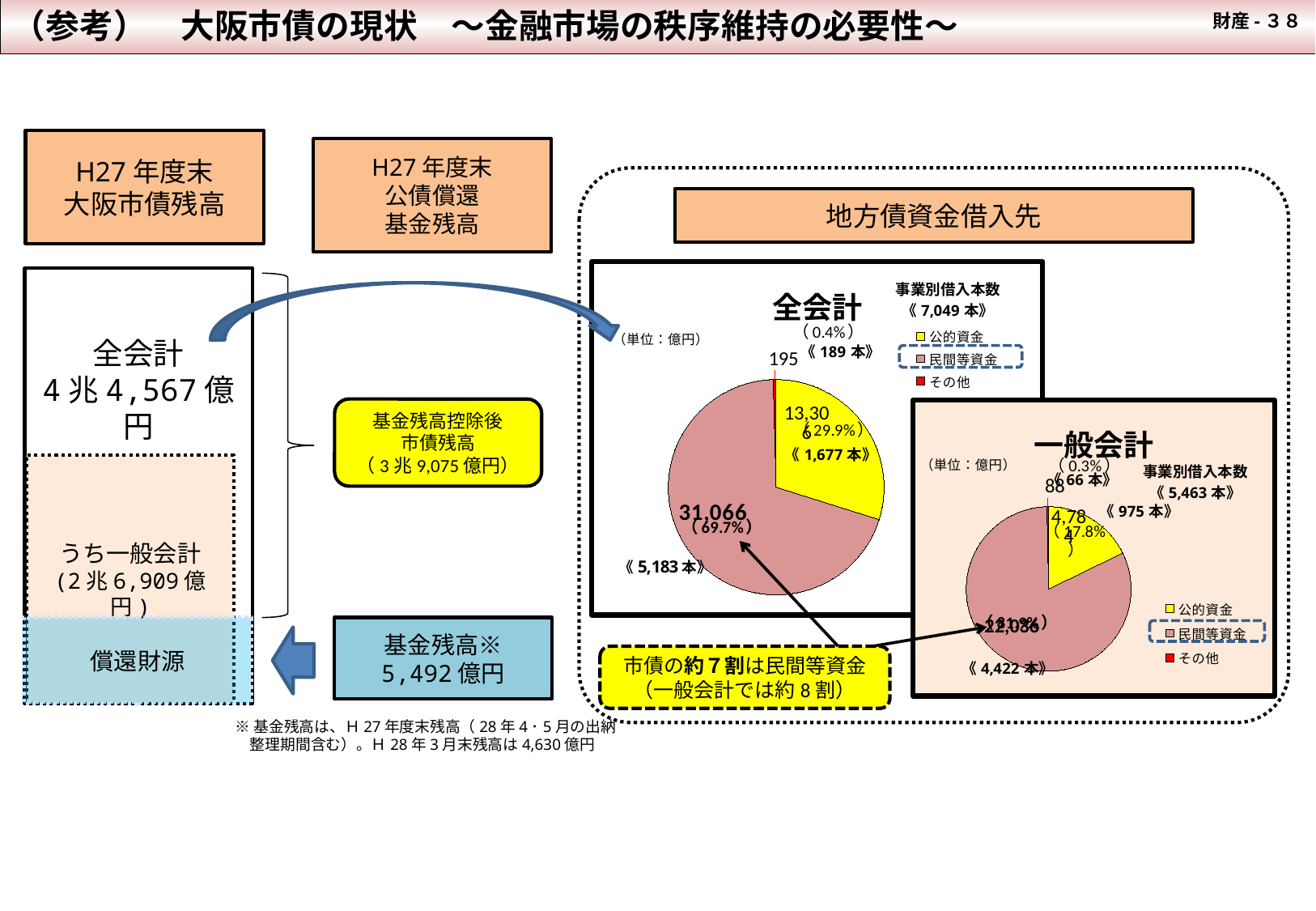
In the 一般会計 pie chart, which is larger, 公的資金 or 民間等資金? 民間等資金 In the 一般会計 pie chart, what is the value for その他? 88 In the 一般会計 pie chart, what share of the pie does その他 take? 0.3% How many series does the legend of the 全会計 chart list? 3 How many slices does the 一般会計 pie chart have? 3 In the 全会計 pie chart, which category has the smallest slice? その他 What kind of chart is the 全会計 chart? pie chart In the 全会計 pie chart, what is the value for 民間等資金? 31,066 In the 全会計 pie chart, what is the value for その他? 195 In the 全会計 pie chart, what share of the pie does その他 take? 0.4% In the 全会計 pie chart, what share of the pie does 民間等資金 take? 69.7% In the 全会計 pie chart, which category has the largest slice? 民間等資金